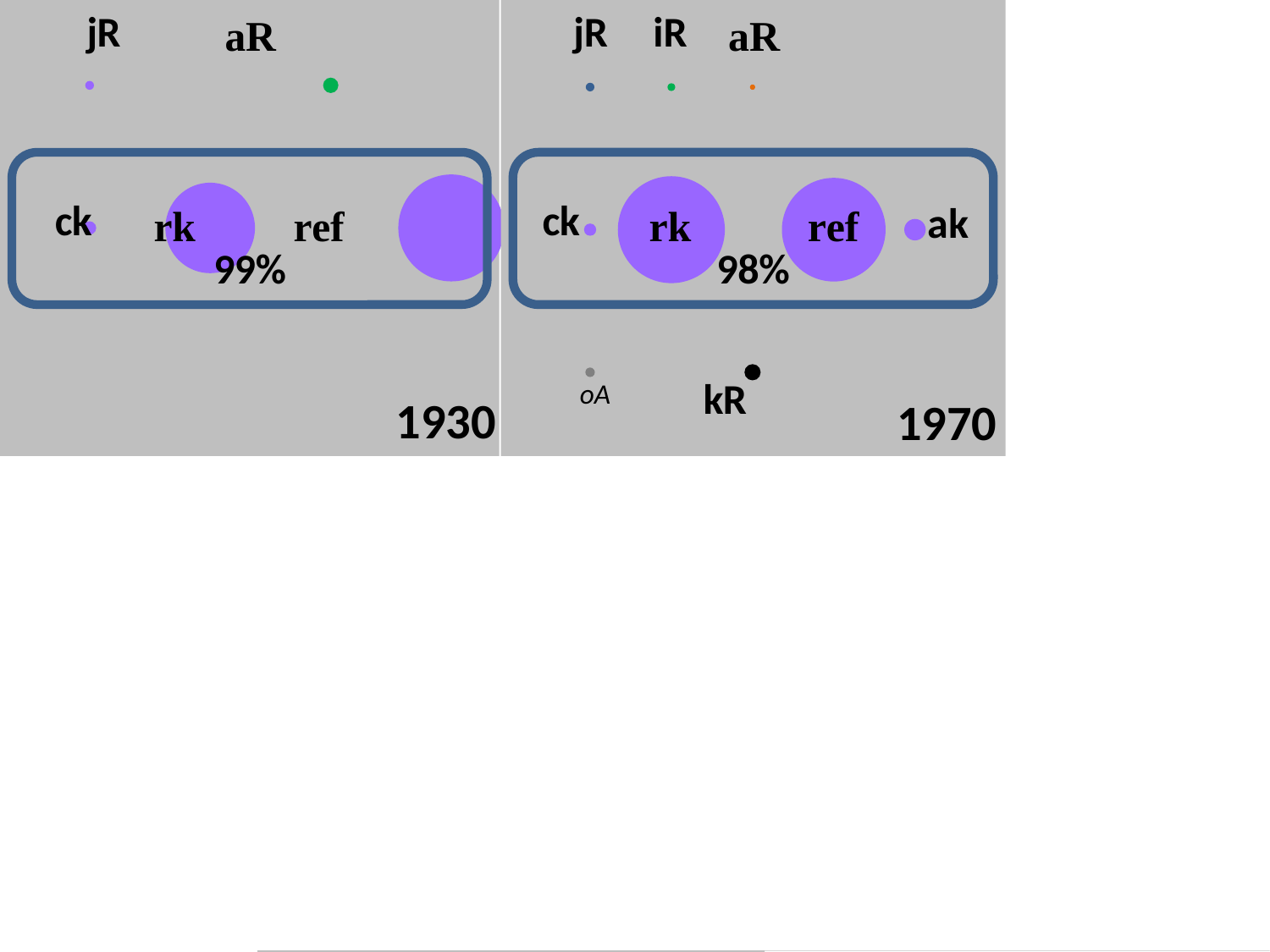
In the 1930 panel, which bubble is larger, rk or jR? rk What percentage is printed inside the outlined box in the 1930 panel? 99% What is the difference between the percentage shown in the 1930 panel and the percentage shown in the 1970 panel? 1% What percentage is printed inside the outlined box in the 1970 panel? 98% How many labelled bubbles are in the 1970 panel? 9 How many labelled bubbles are in the 1930 panel? 5 In the 1970 panel, which bubble is larger, ref or ak? ref In the 1970 panel, which bubble is larger, rk or ck? rk In the 1970 panel, what colour is the kR bubble? black What kind of chart is shown in each panel? bubble chart Which two years label the two panels? 1930 and 1970